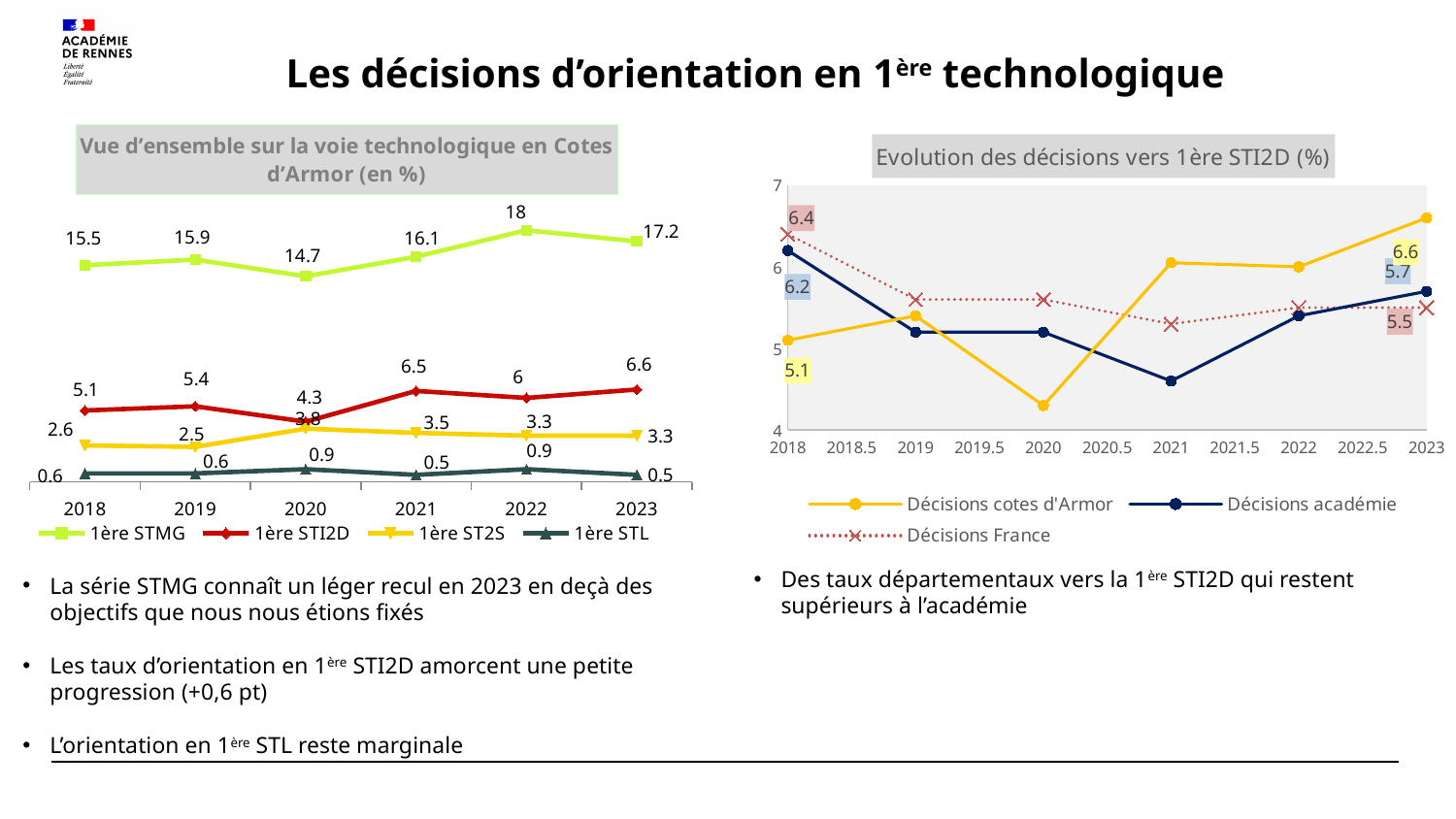
In the chart 'Evolution des décisions vers 1ère STI2D (%)', is the value for Décisions cotes d'Armor in 2020 greater or less than 5? less In the chart 'Vue d'ensemble sur la voie technologique en Cotes d'Armor (en %)', what is the value for 1ère STI2D in 2020? 4.3 How many series does the legend of the chart 'Vue d'ensemble sur la voie technologique en Cotes d'Armor (en %)' list? 4 In the chart 'Evolution des décisions vers 1ère STI2D (%)', what is the value for Décisions cotes d'Armor in 2023? 6.6 In the chart 'Vue d'ensemble sur la voie technologique en Cotes d'Armor (en %)', what is the value for 1ère STL in 2021? 0.5 In the chart 'Vue d'ensemble sur la voie technologique en Cotes d'Armor (en %)', what is the difference between the 1ère STMG values for 2022 and 2023? 0.8 How many series does the legend of the chart 'Evolution des décisions vers 1ère STI2D (%)' list? 3 In the chart 'Evolution des décisions vers 1ère STI2D (%)', what is the value for Décisions France in 2018? 6.4 In the chart 'Vue d'ensemble sur la voie technologique en Cotes d'Armor (en %)', what is the value for 1ère STMG in 2022? 18 In the chart 'Vue d'ensemble sur la voie technologique en Cotes d'Armor (en %)', in which year is the 1ère STMG value highest? 2022 What kind of chart is 'Vue d'ensemble sur la voie technologique en Cotes d'Armor (en %)'? Line chart In the chart 'Evolution des décisions vers 1ère STI2D (%)', which is larger in 2023: Décisions cotes d'Armor or Décisions académie? Décisions cotes d'Armor